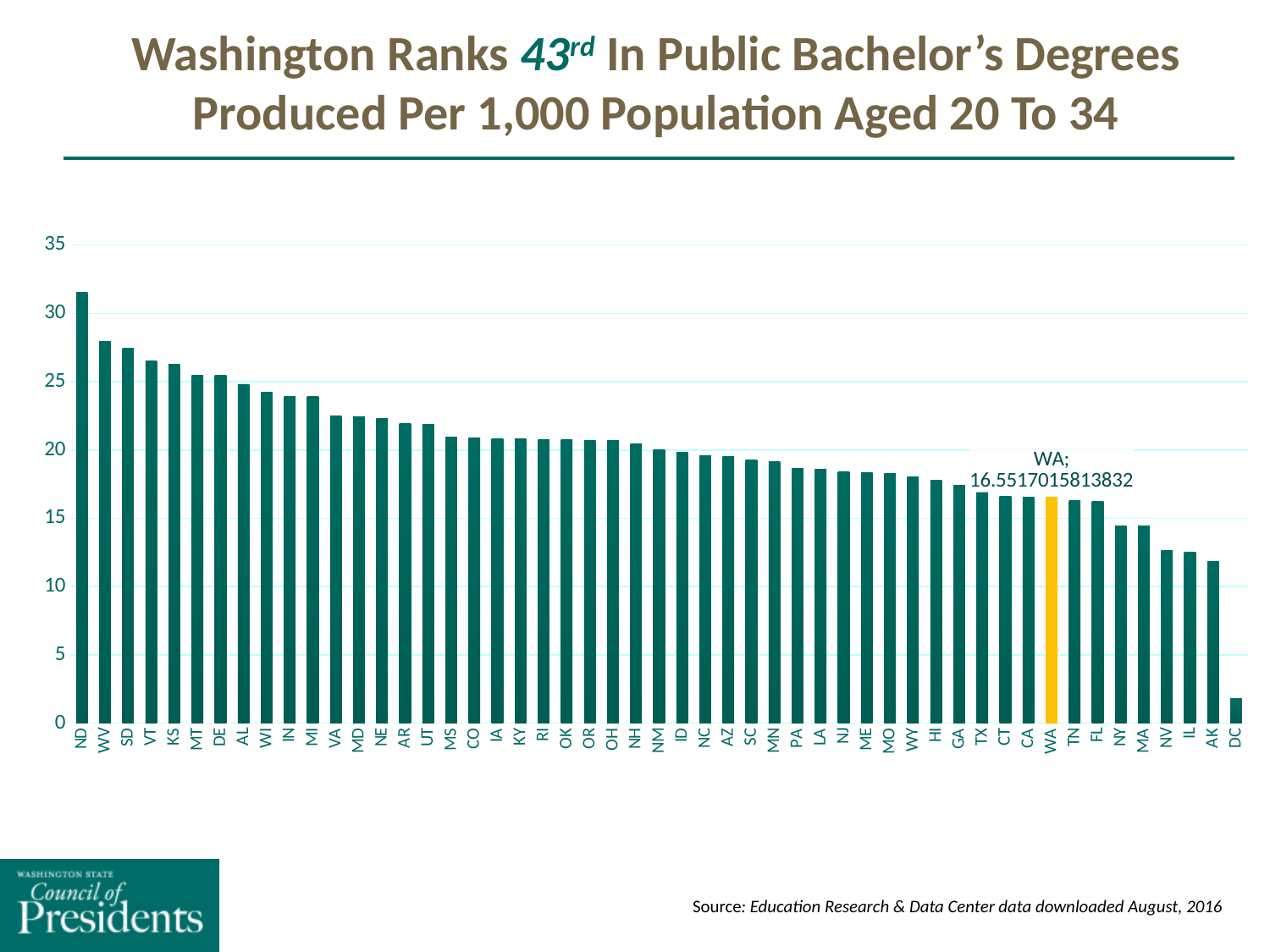
Is the value for AK greater or less than 15? less How many categories (bars) are shown on the chart? 51 Which has a larger value, WA or NY? WA Is the value for WV greater or less than 25? greater What value is labeled for WA on the chart? 16.5517015813832 Which category has the lowest bar on the chart? DC Do the values rise or fall moving from left to right along the x axis? fall Is the value for ND greater or less than 30? greater Which state has the highest bar on the chart? ND Which has a larger value, ND or WV? ND What kind of chart is shown on the slide? bar chart